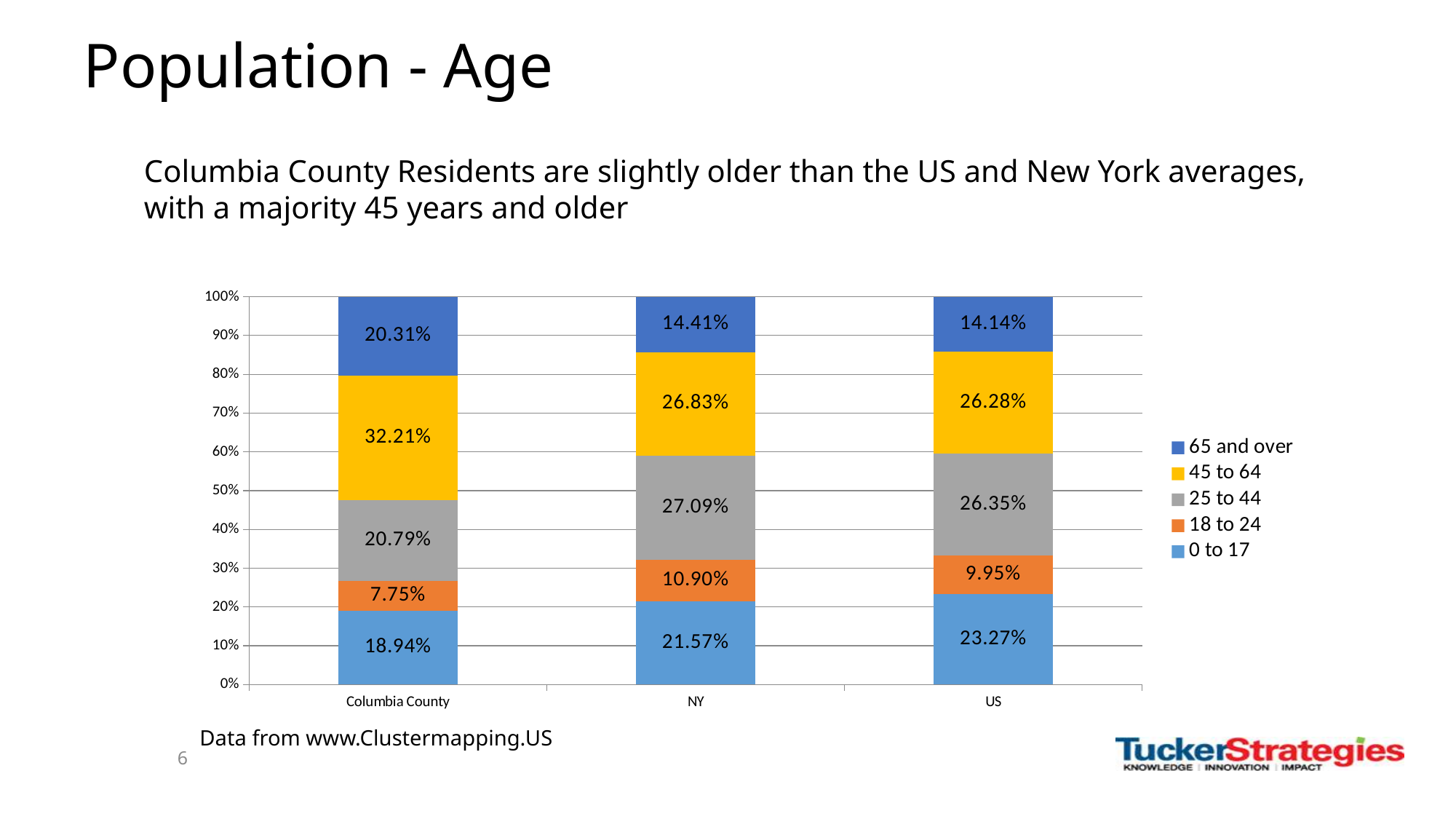
What percentage of Columbia County's population is 65 and over? 20.31% What share of NY's population is 25 to 44? 27.09% How many series does the legend list? 5 What is the value for the 0 to 17 age group in the US? 23.27% What is the difference between the 65 and over values for Columbia County and the US? 6.17% How many categories are shown on the x axis? 3 What is the combined share of the 45 to 64 and 65 and over groups for Columbia County? 52.52% Which is larger: the 0 to 17 value for NY or for the US? US Which category has the highest value for the 45 to 64 age group? Columbia County What kind of chart is shown on the slide? Stacked bar chart Which category has the lowest value for the 18 to 24 age group? Columbia County Which colour represents the 25 to 44 age group in the legend? Grey